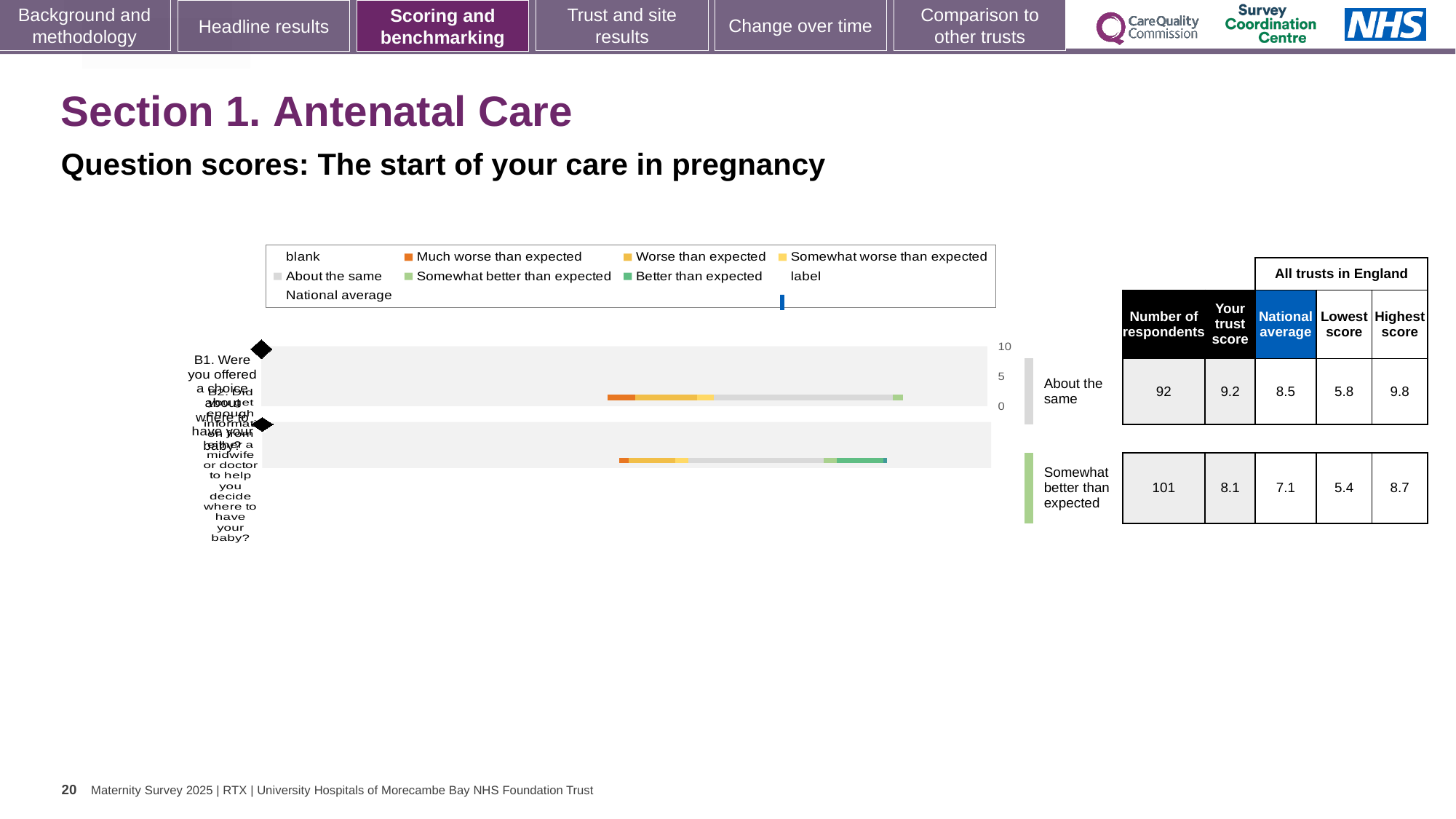
By how much does the trust score for question B1 exceed the national average for B1? 0.7 What benchmark category is shown next to the chart for question B2? Somewhat better than expected How many questions (bars) are plotted in the chart? 2 In the table, what is the highest score across all trusts in England for question B2? 8.7 In the table, what is the trust score for question B2? 8.1 In the table, what is the trust score for question B1? 9.2 In the table, what is the number of respondents for question B2? 101 In the table, what is the lowest score across all trusts in England for question B1? 5.8 What kind of chart is shown on the slide? bar chart In the table, what is the number of respondents for question B1 (Were you offered a choice about where to have your baby)? 92 Which question had more respondents, B1 or B2? B2 In the table, what is the national average for question B1? 8.5